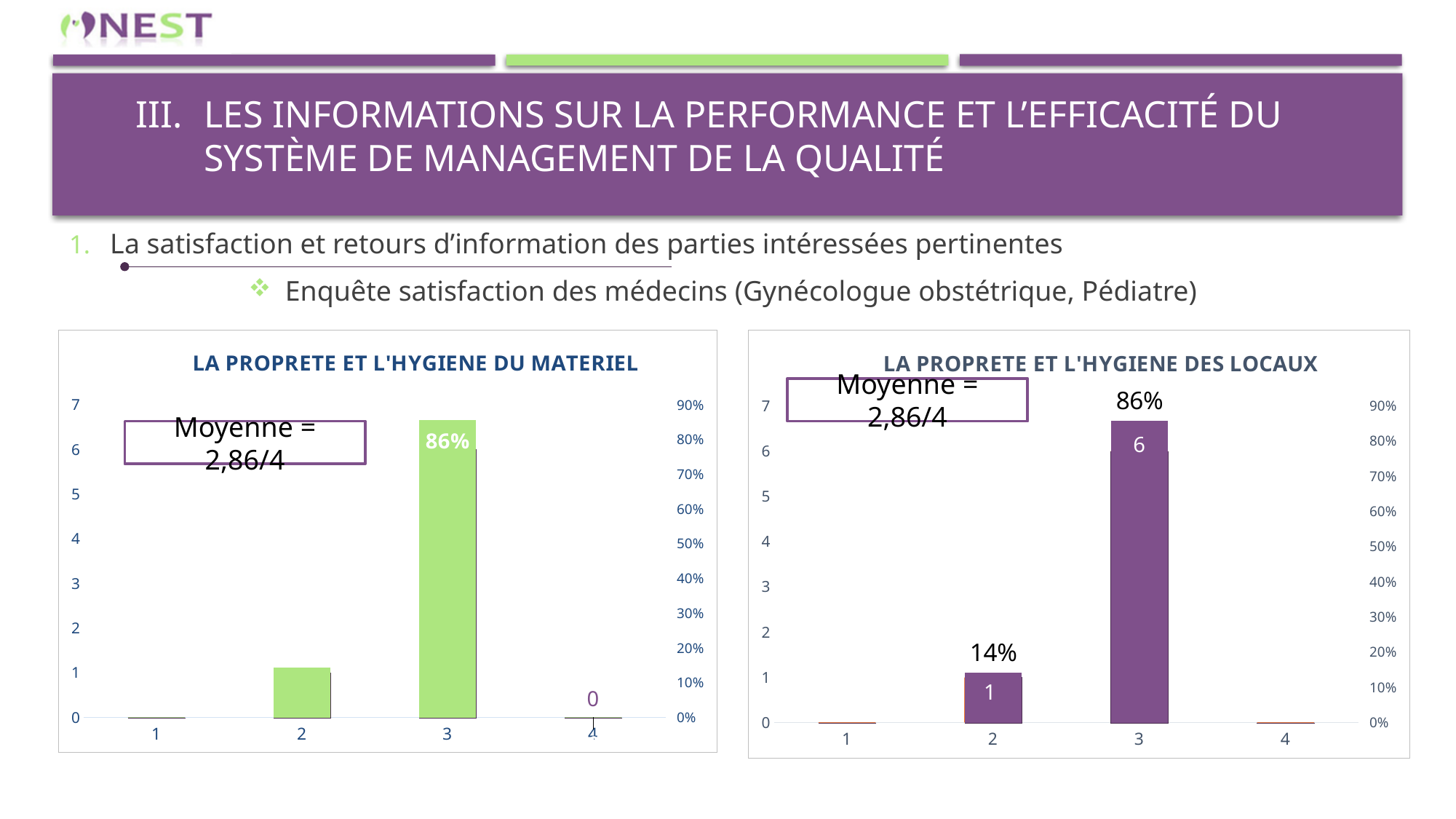
In the chart titled "LA PROPRETE ET L'HYGIENE DES LOCAUX", what percentage is shown above the bar for category 2? 14% In the chart titled "LA PROPRETE ET L'HYGIENE DES LOCAUX", which is larger, the bar for category 2 or the bar for category 3? 3 In the chart titled "LA PROPRETE ET L'HYGIENE DES LOCAUX", what is the difference between the counts for category 3 and category 2? 5 In the chart titled "LA PROPRETE ET L'HYGIENE DU MATERIEL", what value is labelled for category 4? 0 How many categories are shown on the x axis of the chart titled "LA PROPRETE ET L'HYGIENE DU MATERIEL"? 4 In the chart titled "LA PROPRETE ET L'HYGIENE DES LOCAUX", what is the count shown on the bar for category 3? 6 In the chart titled "LA PROPRETE ET L'HYGIENE DES LOCAUX", what percentage is shown above the bar for category 3? 86% In the chart titled "LA PROPRETE ET L'HYGIENE DU MATERIEL", which category has the tallest bar? 3 In the chart titled "LA PROPRETE ET L'HYGIENE DES LOCAUX", which category has the highest bar? 3 In the chart titled "LA PROPRETE ET L'HYGIENE DU MATERIEL", what percentage label is shown on the bar for category 3? 86% In the chart titled "LA PROPRETE ET L'HYGIENE DU MATERIEL", is the value for category 2 greater or less than 3? less What type of chart is the chart titled "LA PROPRETE ET L'HYGIENE DES LOCAUX"? bar chart